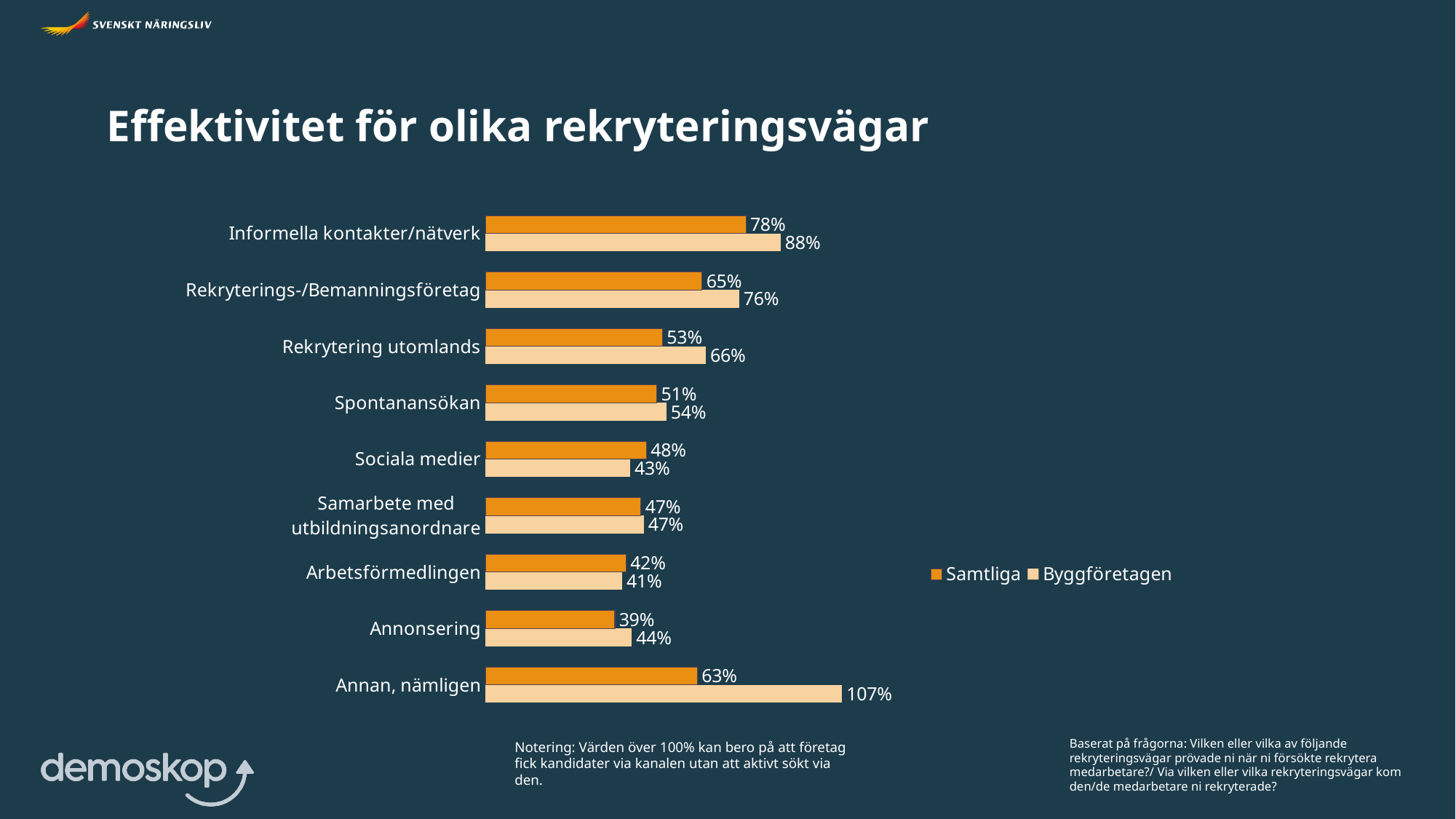
How many categories are shown in the chart? 9 What is the value for Byggföretagen for Annan, nämligen? 107% What is the difference between the Byggföretagen and Samtliga values for Rekryterings-/Bemanningsföretag? 11 percentage points Which category has the lowest value for Samtliga? Annonsering What is the title of the chart on the slide? Effektivitet för olika rekryteringsvägar How many series does the legend list? 2 What kind of chart is shown on the slide? Bar chart Which category has the highest value for Samtliga? Informella kontakter/nätverk For Sociala medier, which series has the larger value, Samtliga or Byggföretagen? Samtliga What is the value for Samtliga for Informella kontakter/nätverk? 78% What is the value for Byggföretagen for Rekrytering utomlands? 66% Which category has the lowest value for Byggföretagen? Arbetsförmedlingen